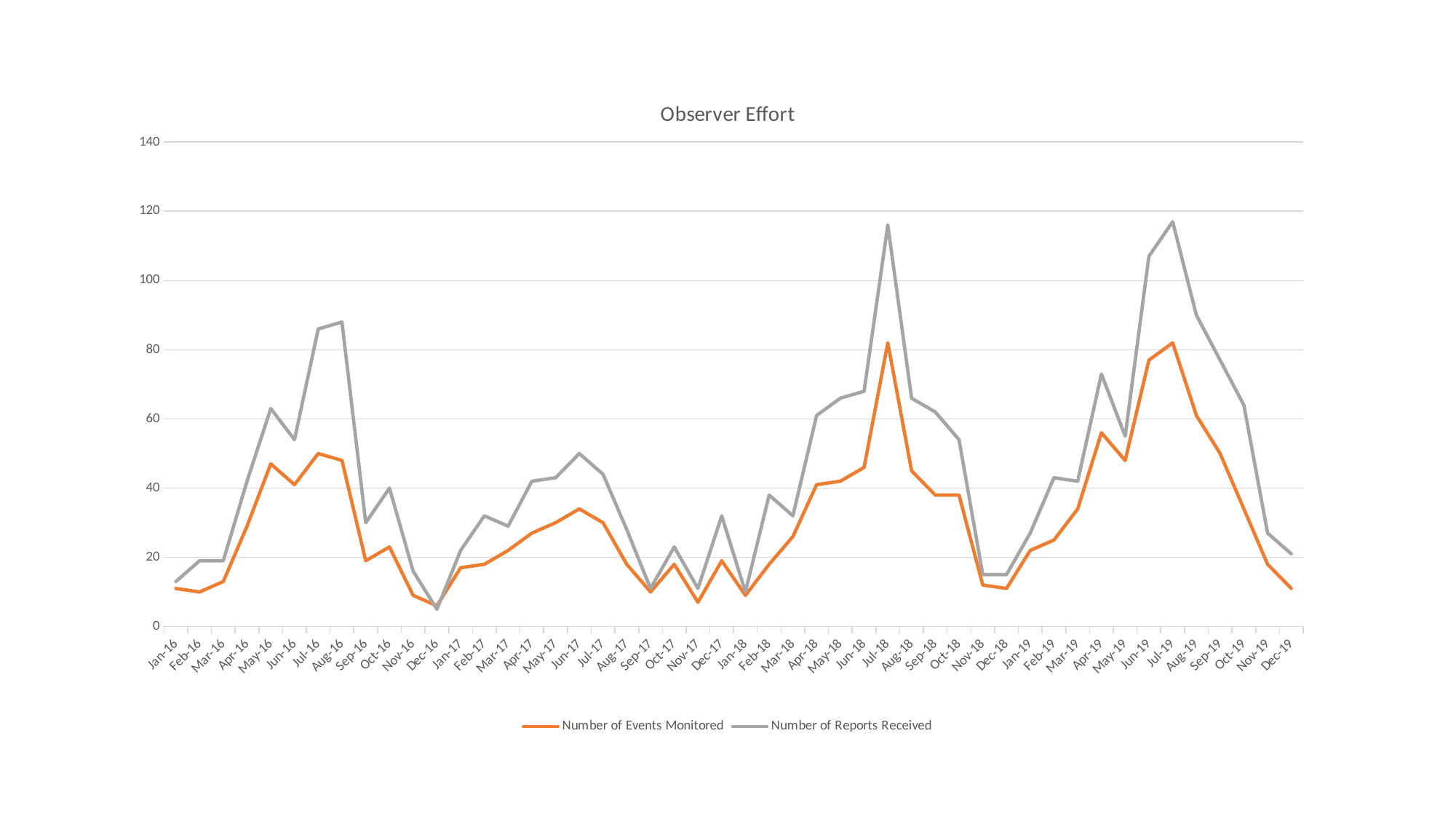
In Jul-18, which series has the larger value, Number of Events Monitored or Number of Reports Received? Number of Reports Received Is the value for Number of Events Monitored in Dec-16 greater or less than 20? less Is the value for Number of Reports Received in Jun-17 greater or less than 60? less Which colour is the Number of Events Monitored line? orange In which month is Number of Reports Received lowest? Dec-16 Is the value for Number of Reports Received in Aug-16 greater or less than 80? greater What is the title of the chart? Observer Effort How many series does the legend list? 2 Does Number of Reports Received rise or fall from Jul-19 to Dec-19? fall What kind of chart is shown on the slide? line chart How many months are shown along the x axis? 48